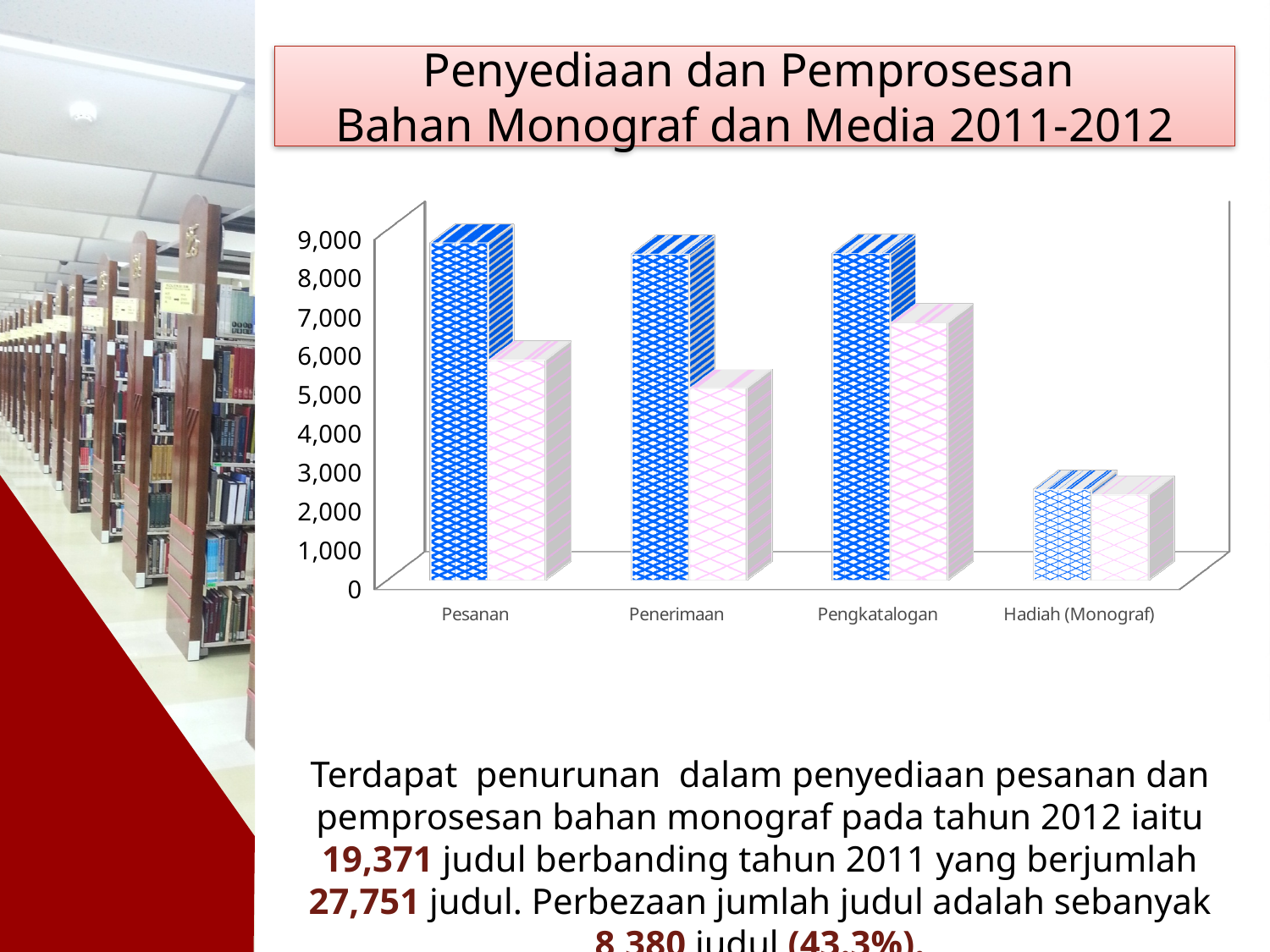
How many categories are shown on the x axis of the chart? 4 Is the blue bar for Hadiah (Monograf) greater or less than 3,000? less For Pengkatalogan, which is larger: the blue bar or the pink bar? the blue bar Is the blue bar for Pesanan greater or less than 8,000? greater Which category has the lowest blue bar in the chart? Hadiah (Monograf) What kind of chart is shown on the slide? bar chart What is the highest value shown on the vertical axis of the chart? 9,000 Which category has the lowest pink bar in the chart? Hadiah (Monograf) Is the pink bar for Penerimaan greater or less than 6,000? less What is the title of the slide containing the chart? Penyediaan dan Pemprosesan Bahan Monograf dan Media 2011-2012 How many bars are plotted for each category in the chart? 2 Which category has the highest pink bar in the chart? Pengkatalogan